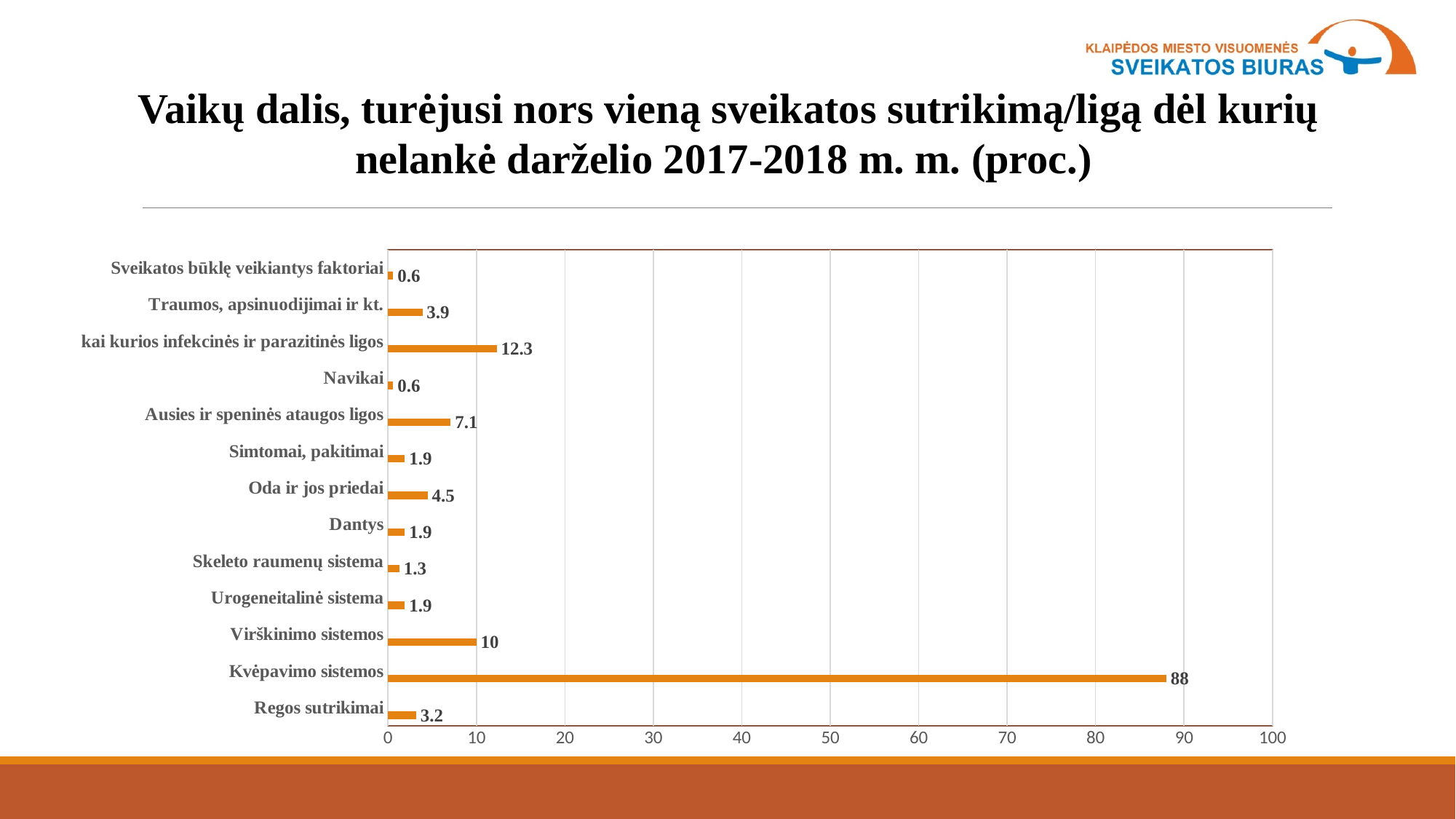
What is the difference between the values for Kvėpavimo sistemos and Virškinimo sistemos? 78 What is the value for Kvėpavimo sistemos? 88 What is the value for Ausies ir speninės ataugos ligos? 7.1 Is the value for Kvėpavimo sistemos greater or less than 80? greater What kind of chart is shown on the slide? bar chart What is the value for Regos sutrikimai? 3.2 Which is larger, the value for Oda ir jos priedai or the value for Traumos, apsinuodijimai ir kt.? Oda ir jos priedai What is the value for kai kurios infekcinės ir parazitinės ligos? 12.3 How many categories are shown in the chart? 13 What is the maximum value shown on the horizontal axis? 100 Which category has the highest value? Kvėpavimo sistemos What is the difference between the values for kai kurios infekcinės ir parazitinės ligos and Traumos, apsinuodijimai ir kt.? 8.4